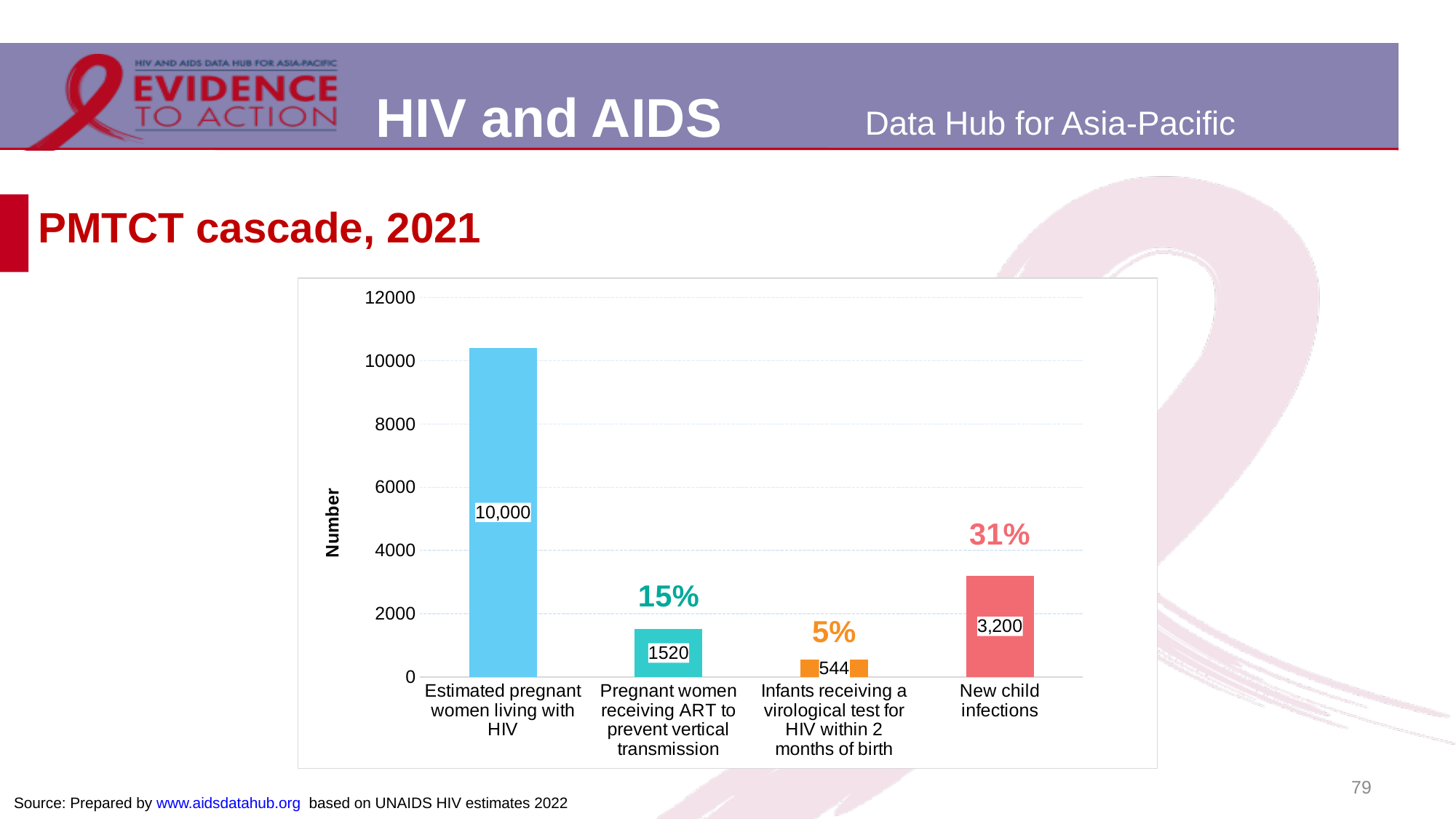
What is the difference between the value for Estimated pregnant women living with HIV and the value for New child infections? 6,800 Which category has the highest value? Estimated pregnant women living with HIV What percentage is shown above the Pregnant women receiving ART to prevent vertical transmission bar? 15% What is the value for Infants receiving a virological test for HIV within 2 months of birth? 544 How many categories are shown on the x axis? 4 What kind of chart is this? Bar chart Which is larger: the value for New child infections or the value for Pregnant women receiving ART to prevent vertical transmission? New child infections What is the value for New child infections? 3,200 What is the value for Pregnant women receiving ART to prevent vertical transmission? 1520 Which category has the lowest value? Infants receiving a virological test for HIV within 2 months of birth What is the value for Estimated pregnant women living with HIV? 10,000 What percentage is shown above the New child infections bar? 31%